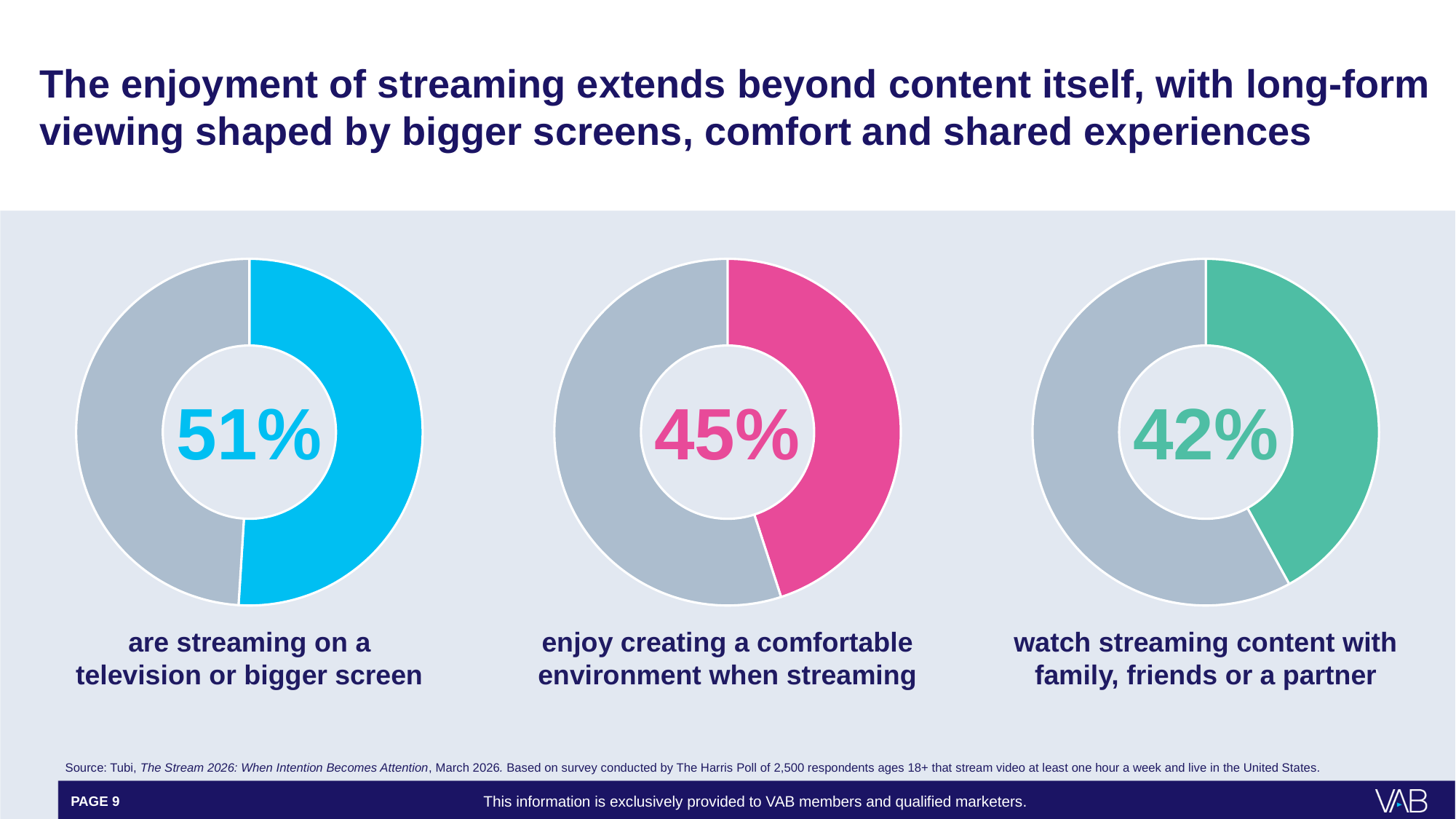
In the middle donut chart, what percentage enjoy creating a comfortable environment when streaming? 45% What is the difference between the middle donut chart's value and the right donut chart's value? 3 percentage points Is the value in the left donut chart greater or less than 50%? greater What kind of chart is used to display the three percentages on the slide? donut (pie) chart What colour is the highlighted segment in the middle donut chart? pink In the left donut chart, what percentage are streaming on a television or bigger screen? 51% Which of the three donut charts shows the highest percentage? are streaming on a television or bigger screen (51%) Which of the three donut charts shows the lowest percentage? watch streaming content with family, friends or a partner (42%) How many donut charts are shown on the slide? 3 In the right donut chart, what percentage watch streaming content with family, friends or a partner? 42% What is the difference between the percentage streaming on a television or bigger screen and the percentage watching with family, friends or a partner? 9 percentage points Which is larger: the percentage who enjoy creating a comfortable environment when streaming, or the percentage who watch streaming content with family, friends or a partner? enjoy creating a comfortable environment when streaming